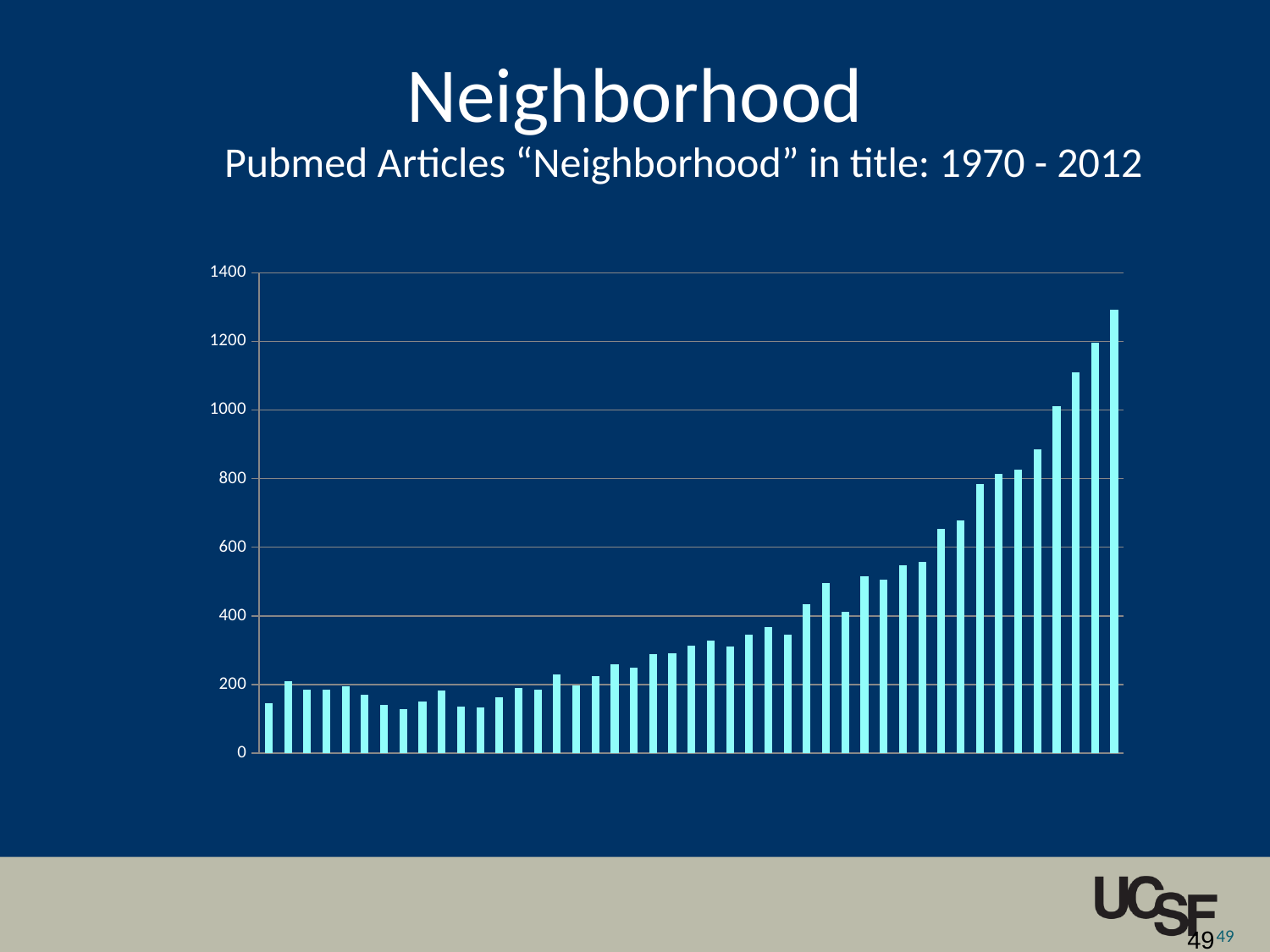
Is the value of the rightmost bar greater or less than 1200? greater Is the value of the leftmost bar greater or less than 200? less Overall, do the bar values rise or fall from left to right across the chart? rise Which bar is the tallest in the chart? the rightmost bar Which is larger, the value of the leftmost bar or the value of the rightmost bar? the rightmost bar What kind of chart is shown on the slide? bar chart Is the value of the second bar from the right greater or less than 1000? greater What is the subtitle describing the chart's data? Pubmed Articles "Neighborhood" in title: 1970 - 2012 What is the highest value shown on the vertical axis? 1400